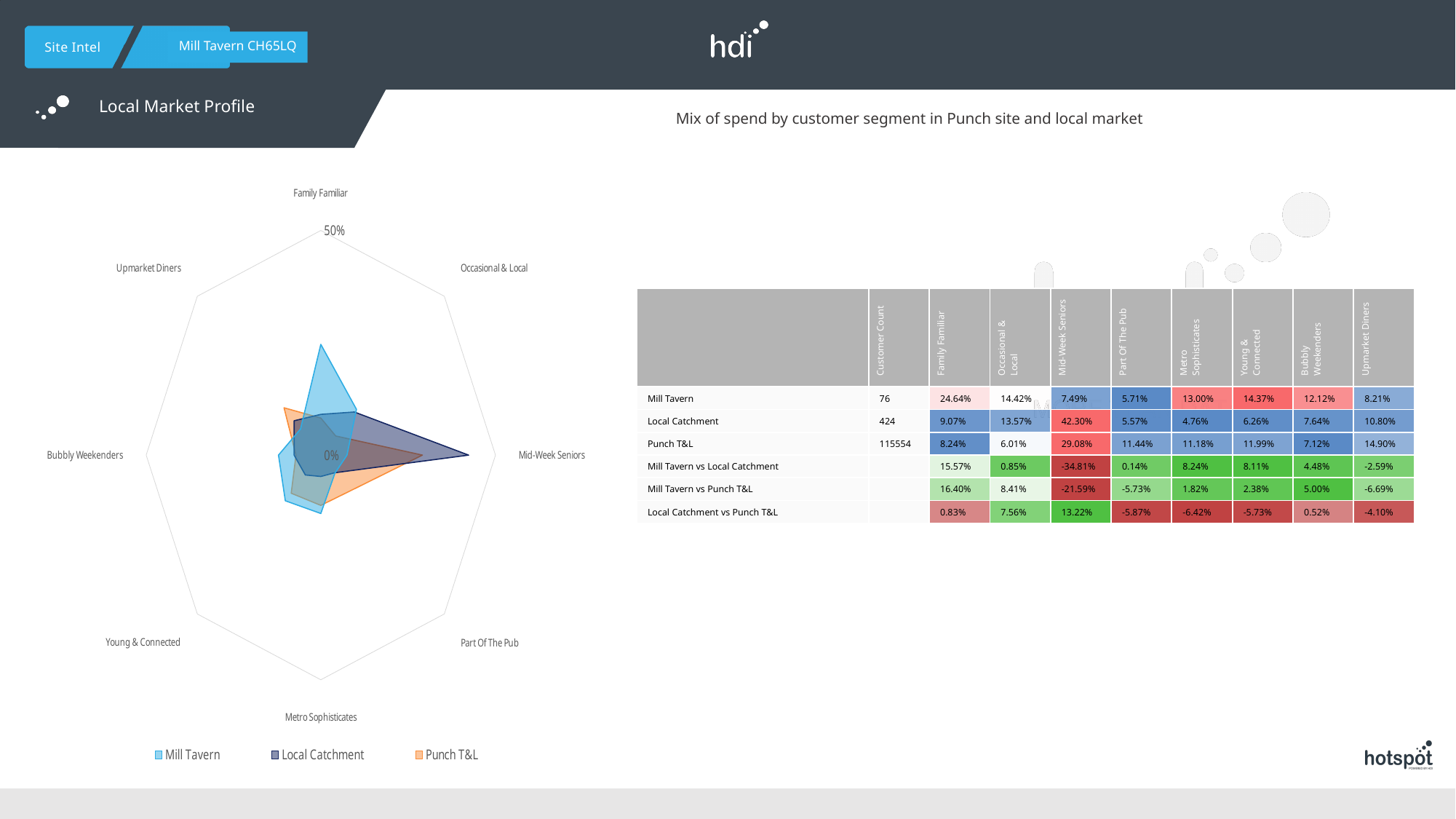
Which segment has the highest share of spend for Mill Tavern? Family Familiar Is the Local Catchment value for Mid-Week Seniors greater or less than 50%? less According to the table, what is the Mill Tavern share of spend for Family Familiar? 24.64% What is the highest percentage value shown on the radar chart's axis scale? 50% Which series is shown in orange on the radar chart? Punch T&L According to the table, what is the Punch T&L share of spend for Upmarket Diners? 14.90% What kind of chart is shown on the left of the slide? Radar chart How many customer segments (axes) does the radar chart have? 8 Which segment has the highest share of spend for Local Catchment? Mid-Week Seniors How many series does the radar chart's legend list? 3 According to the table, what is the Local Catchment share of spend for Mid-Week Seniors? 42.30% Which is larger: the Mill Tavern share for Metro Sophisticates or the Local Catchment share for Metro Sophisticates? Mill Tavern